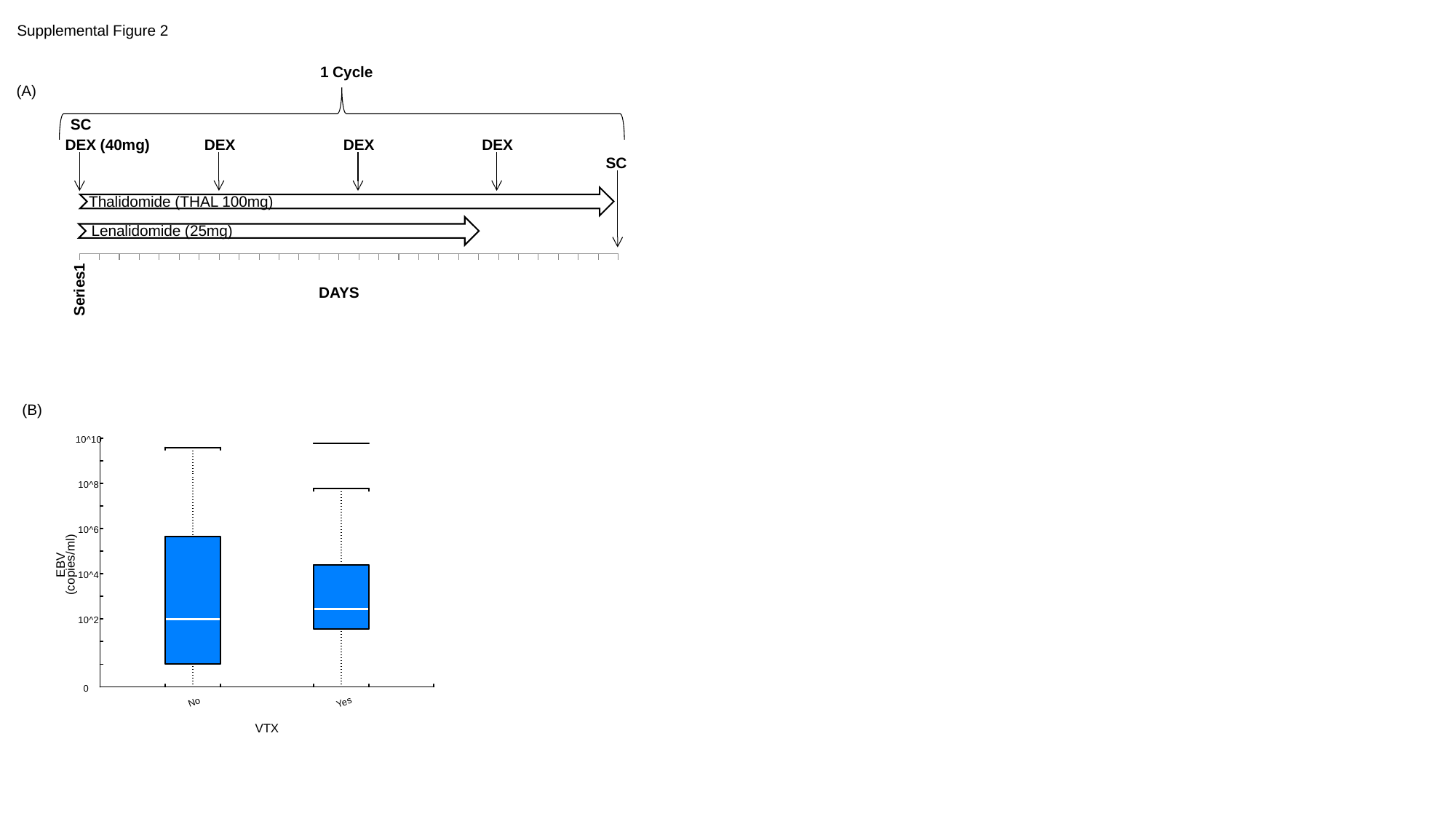
In panel (A), how many DEX arrows are shown within one cycle? 4 In panel (B), is the top of the box for 'Yes' greater or less than 10^4? greater In panel (B), what kind of chart is shown? Box plot In panel (B), is the bottom of the box for 'No' greater or less than 10^2? less In panel (B), is the top of the box for 'No' greater or less than 10^6? less In panel (B), what is the x-axis title? VTX In panel (B), what are the two category labels on the x axis? No and Yes In panel (B), how many categories are shown on the x axis? 2 In panel (A), what dose of Lenalidomide is shown? 25mg In panel (B), which category has the higher top edge of its box, 'No' or 'Yes'? No In panel (B), which category has the lower bottom edge of its box, 'No' or 'Yes'? No In panel (A), what dose of Thalidomide is shown? 100mg